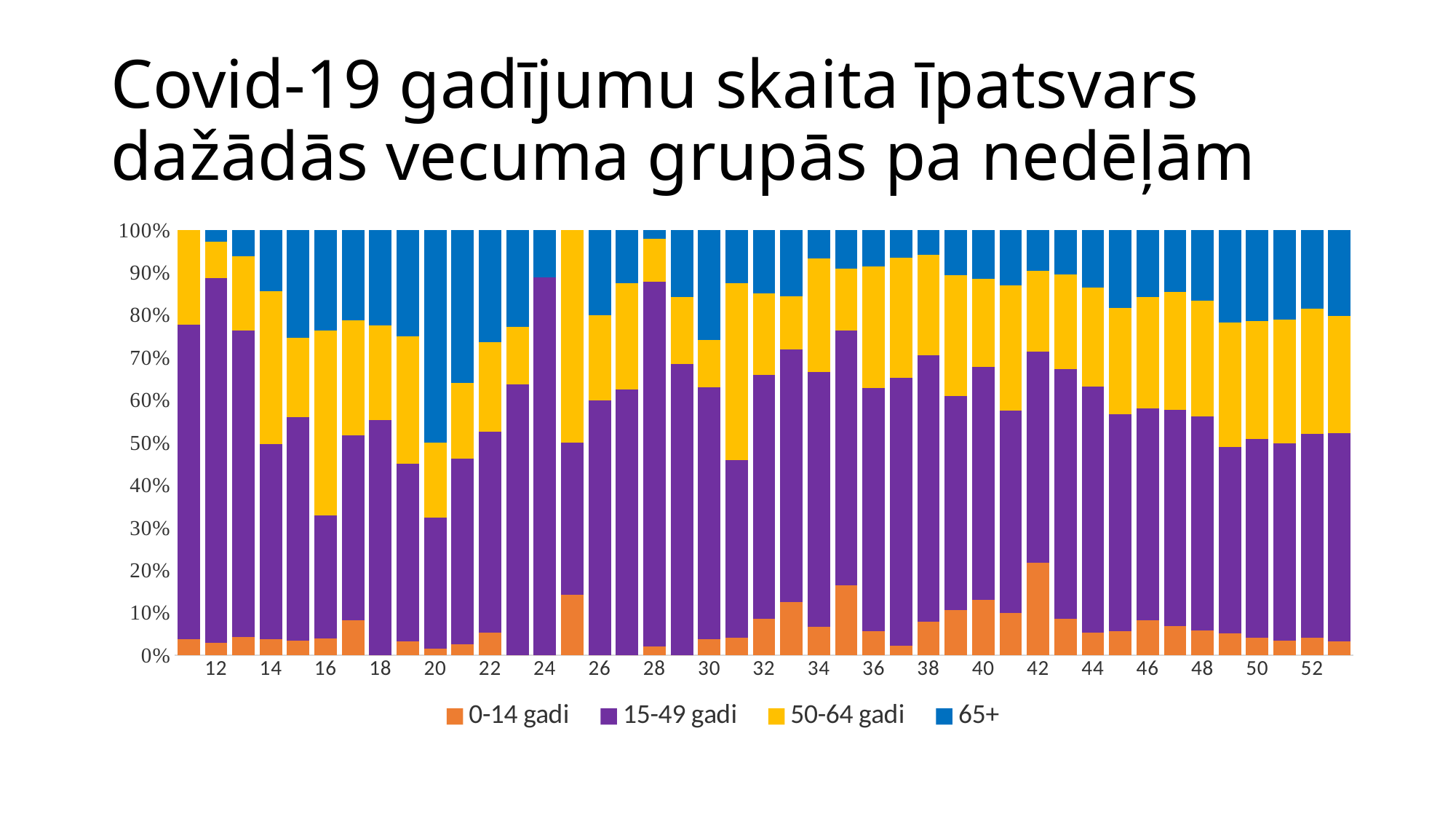
Is the share of the 65+ group in week 12 greater or less than 10%? less Does the share of the 65+ group rise or fall from week 20 to week 24? Fall Which week has the largest share for the 65+ group? 20 What kind of chart is shown on the slide? Stacked bar chart How many series does the legend list? 4 Is the share of the 0-14 gadi group in week 42 greater or less than 20%? greater What is the title of the chart? Covid-19 gadījumu skaita īpatsvars dažādās vecuma grupās pa nedēļām How many weekly bars are plotted in the chart? 43 Is the share of the 65+ group in week 20 greater or less than 40%? greater Which age group is shown in blue in the legend? 65+ Which week has the largest share for the 0-14 gadi group? 42 Which is larger: the 0-14 gadi share in week 42 or in week 12? Week 42